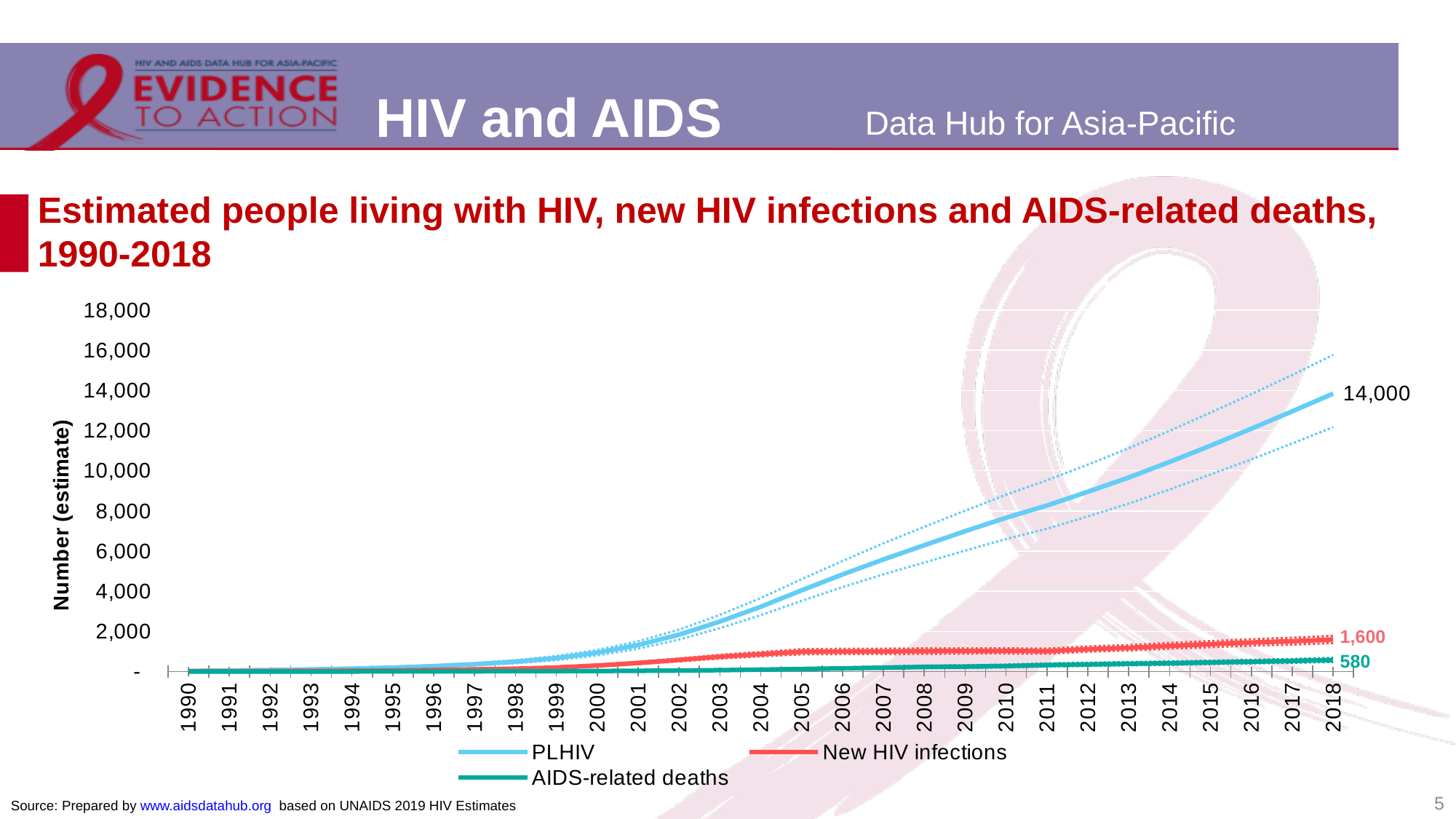
What is the PLHIV value in 2018? 14,000 Which series has the highest value in 2018? PLHIV Does the PLHIV series rise or fall from 1990 to 2018? Rise How many series does the legend list? 3 What is the value for AIDS-related deaths in 2018? 580 In 2018, which is larger: New HIV infections or AIDS-related deaths? New HIV infections What kind of chart is shown on the slide? Line chart What is the difference between the PLHIV value and the New HIV infections value in 2018? 12,400 Which series has the lowest value in 2018? AIDS-related deaths Is the PLHIV value in 2010 greater or less than 10,000? less What is the label of the vertical axis? Number (estimate) What is the value for New HIV infections in 2018? 1,600